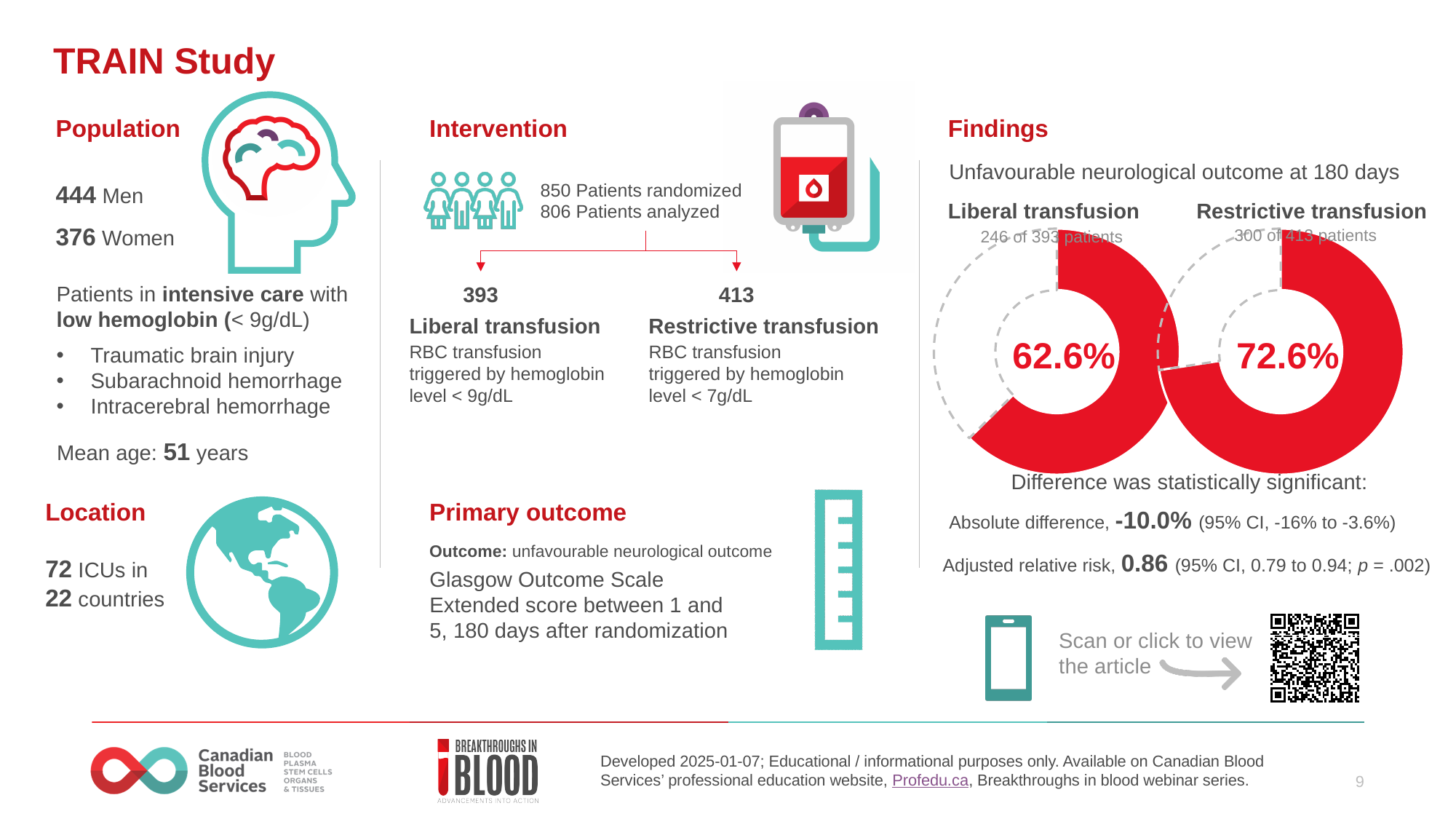
In the Findings doughnut charts, what percentage is shown for the Restrictive transfusion group? 72.6% What outcome do the Findings doughnut charts represent? Unfavourable neurological outcome at 180 days What kind of chart is used in the Findings section to show the outcome percentages? doughnut chart In the Findings doughnut charts, which group has the lower percentage of unfavourable neurological outcome? Liberal transfusion In the Findings doughnut charts, how many patients in the Restrictive transfusion group had an unfavourable neurological outcome? 300 of 413 patients In the Findings doughnut charts, what colour is the filled portion representing the percentage? red In the Findings doughnut charts, which group has the higher percentage of unfavourable neurological outcome? Restrictive transfusion In the Findings doughnut charts, what is the difference in percentage points between the Restrictive transfusion and Liberal transfusion groups? 10.0% How many doughnut charts are shown in the Findings section of the slide? 2 In the Findings doughnut charts, what percentage is shown for the Liberal transfusion group? 62.6% In the Findings doughnut charts, is the percentage for Liberal transfusion larger or smaller than the percentage for Restrictive transfusion? smaller In the Findings doughnut charts, how many patients in the Liberal transfusion group had an unfavourable neurological outcome? 246 of 393 patients